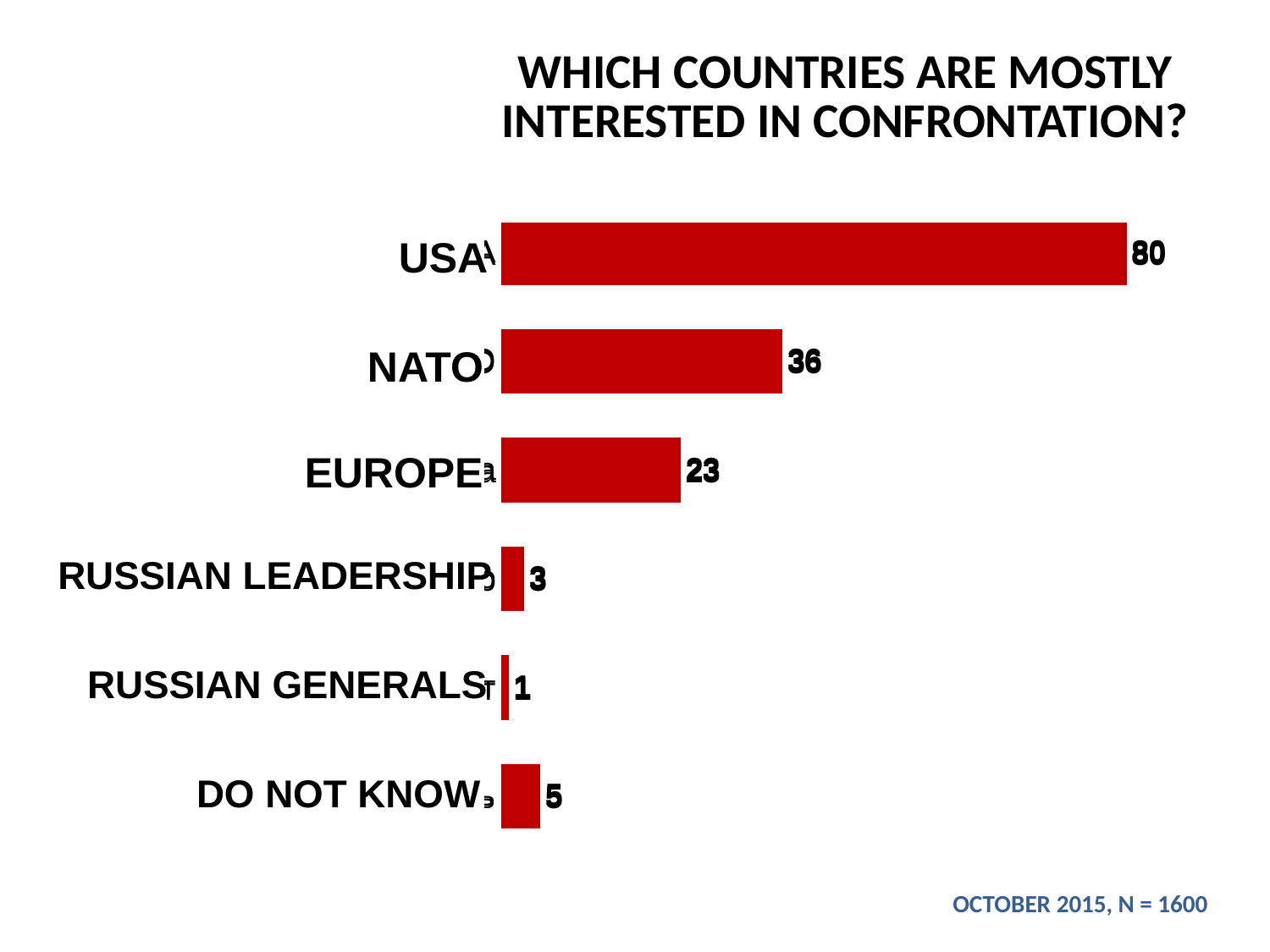
How many categories are shown in the chart? 6 What is the value for NATO? 36 What kind of chart is shown on the slide? Bar chart What is the value for Do not know? 5 What is the title of the chart? Which countries are mostly interested in confrontation? What is the value for Russian leadership? 3 Which category has the lowest value? Russian generals Which is larger, the value for Europe or the value for Do not know? Europe What is the value for Europe? 23 What is the difference between the values for USA and NATO? 44 Which category has the highest value? USA What is the value for USA? 80